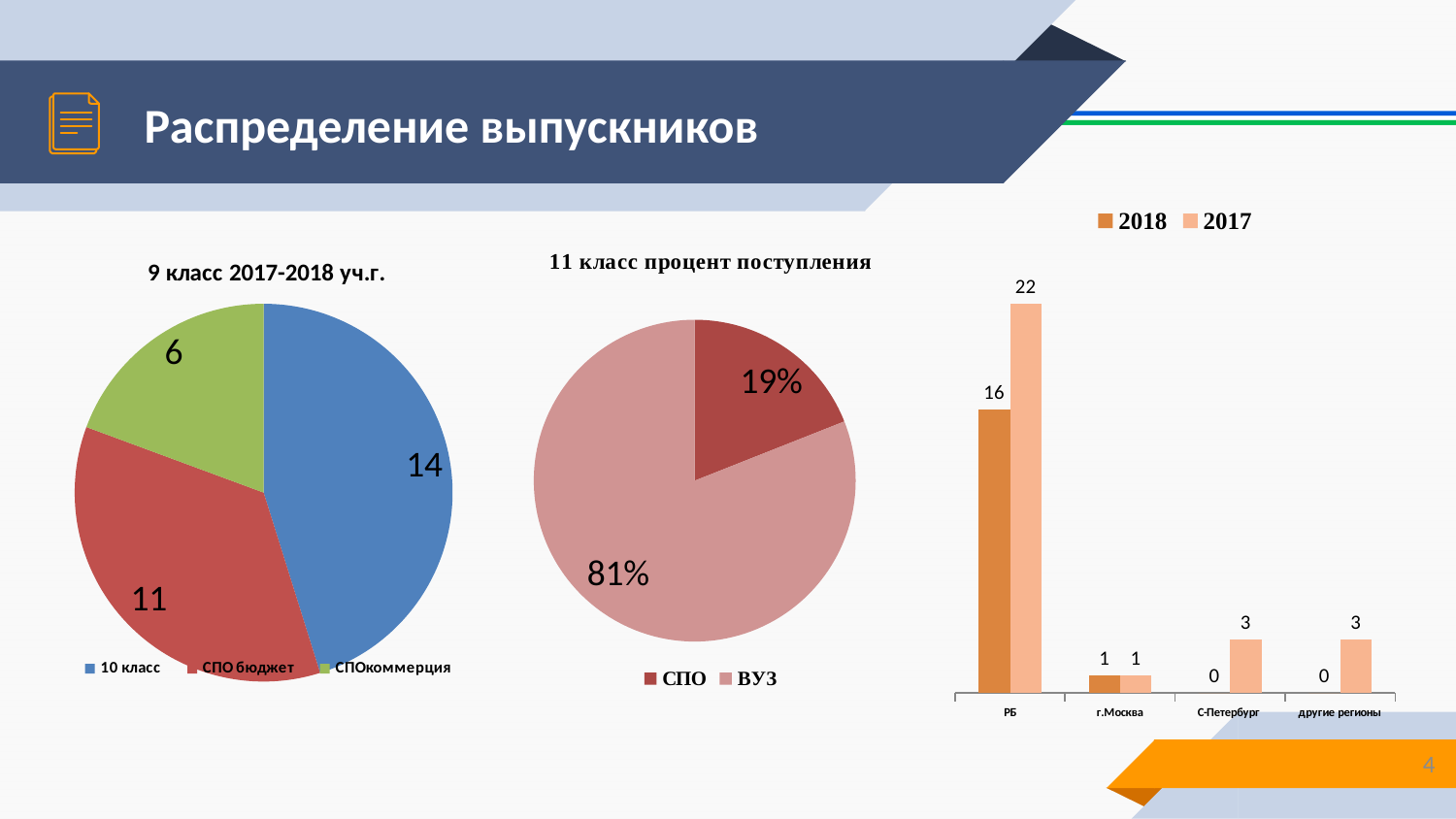
In the bar chart on the right side of the slide, what is the difference between the 2017 and 2018 values for "РБ"? 6 In the pie chart titled "9 класс 2017-2018 уч.г.", what is the difference between the values for "10 класс" and "СПО бюджет"? 3 In the pie chart titled "9 класс 2017-2018 уч.г.", how many categories are shown? 3 In the bar chart on the right side of the slide, how many series does the legend list? 2 In the bar chart on the right side of the slide, what is the value for "С-Петербург" in the 2018 series? 0 What kind of chart is the chart on the right side of the slide? Bar chart In the pie chart titled "9 класс 2017-2018 уч.г.", which category has the smallest value? СПОкоммерция In the pie chart titled "9 класс 2017-2018 уч.г.", what is the value for "10 класс"? 14 In the bar chart on the right side of the slide, what is the value for "РБ" in the 2017 series? 22 In the bar chart on the right side of the slide, which category has the highest value in the 2017 series? РБ In the pie chart titled "11 класс процент поступления", which category has the larger share, "СПО" or "ВУЗ"? ВУЗ In the pie chart titled "11 класс процент поступления", what share does "ВУЗ" have? 81%